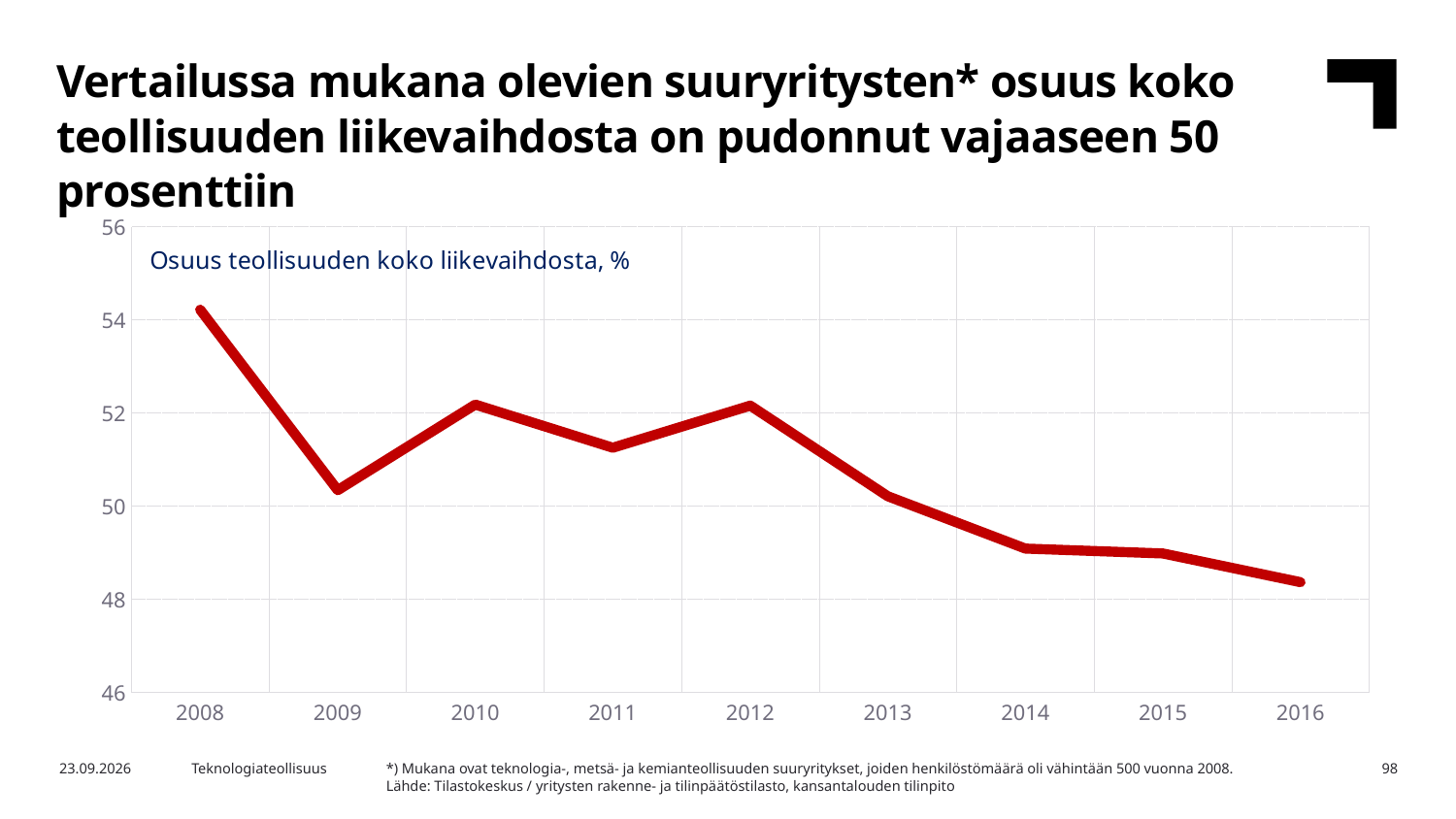
What kind of chart is shown on the slide? line chart Is the value for 2011 greater or less than 50? greater What is the title of the chart? Osuus teollisuuden koko liikevaihdosta, % Which is larger, the value for 2011 or the value for 2013? 2011 Which year has the highest value? 2008 Which year has the lowest value? 2016 Is the value for 2016 greater or less than 50? less Is the value for 2008 greater or less than 52? greater Which is larger, the value for 2008 or the value for 2009? 2008 How many years are plotted on the x axis? 9 Overall, do the values rise or fall from 2008 to 2016? fall